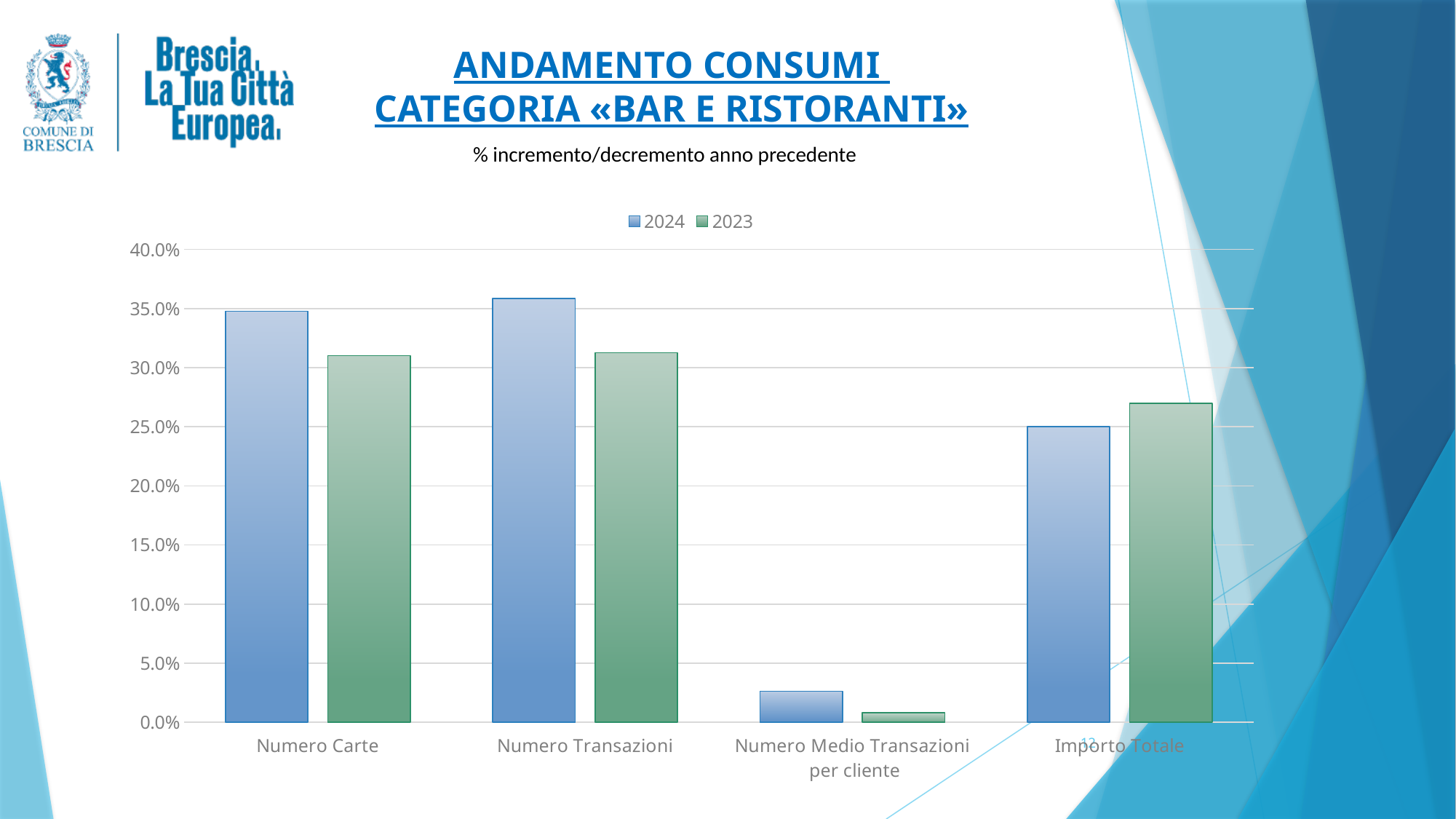
Which colour represents the 2023 series in the legend? green What kind of chart is shown on the slide? bar chart For Numero Transazioni, which series has the larger value, 2024 or 2023? 2024 How many categories are shown on the x axis? 4 Is the 2023 value for Numero Medio Transazioni per cliente greater or less than 5.0%? less Is the 2023 value for Importo Totale greater or less than 25.0%? greater Which category has the lowest 2023 value? Numero Medio Transazioni per cliente Which category has the highest 2024 value? Numero Transazioni How many series does the legend list? 2 Is the 2024 value for Numero Carte greater or less than 30.0%? greater For Importo Totale, which series has the larger value, 2024 or 2023? 2023 What is the subtitle shown above the chart legend? % incremento/decremento anno precedente